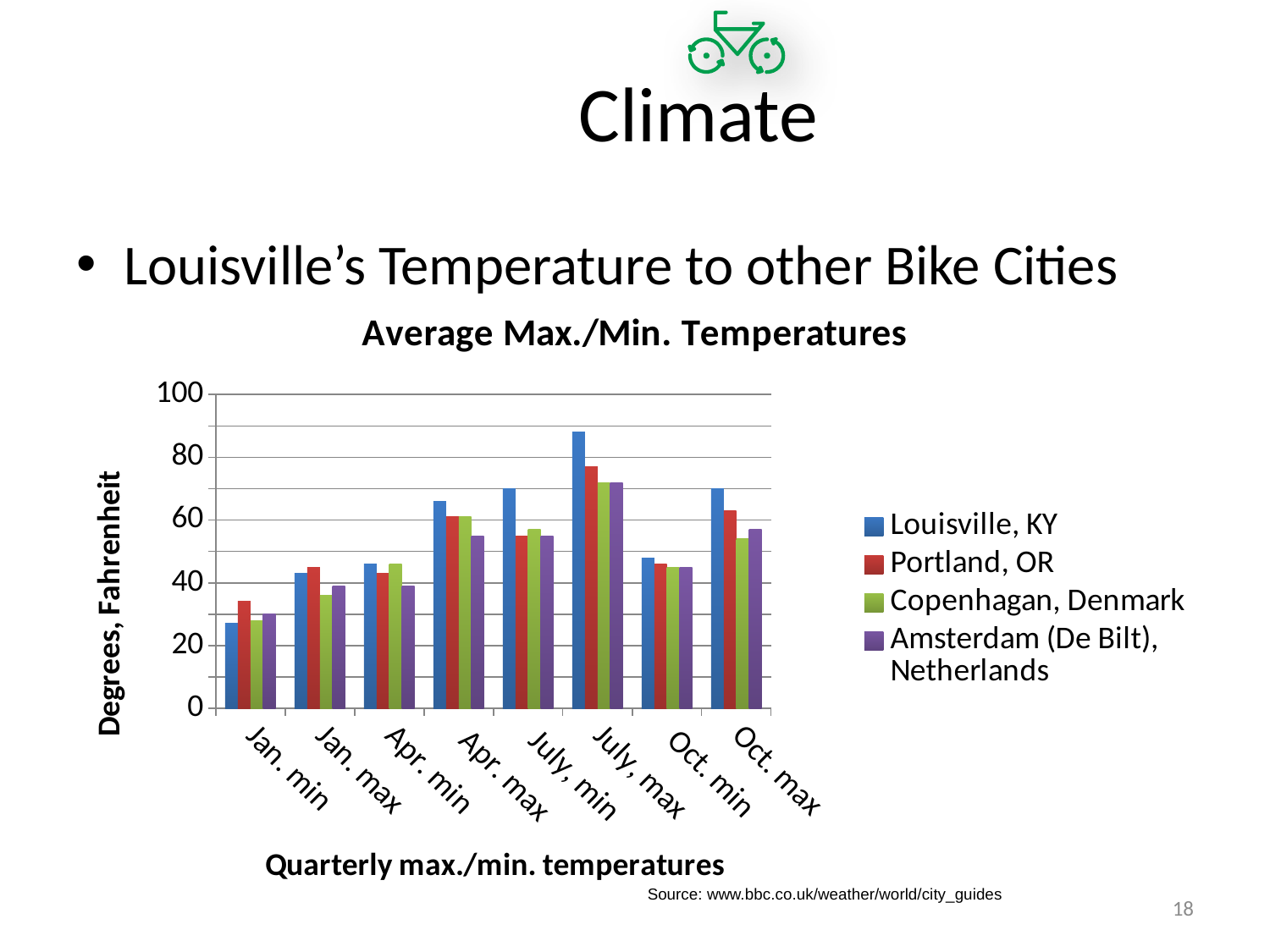
What kind of chart is shown on the slide? Bar chart How many categories are shown along the x axis? 8 Is the value for Portland, OR in Jan. min greater or less than 40? less In Jan. min, which is larger: Portland, OR or Louisville, KY? Portland, OR Is the value for Louisville, KY in July, max greater or less than 80? greater In July, max, which is larger: Louisville, KY or Portland, OR? Louisville, KY Is the value for Amsterdam (De Bilt), Netherlands in Apr. max greater or less than 60? less In which category is the Louisville, KY bar the lowest? Jan. min In which category is the Louisville, KY bar the highest? July, max How many series does the legend list? 4 What is the title of the chart's vertical axis? Degrees, Fahrenheit